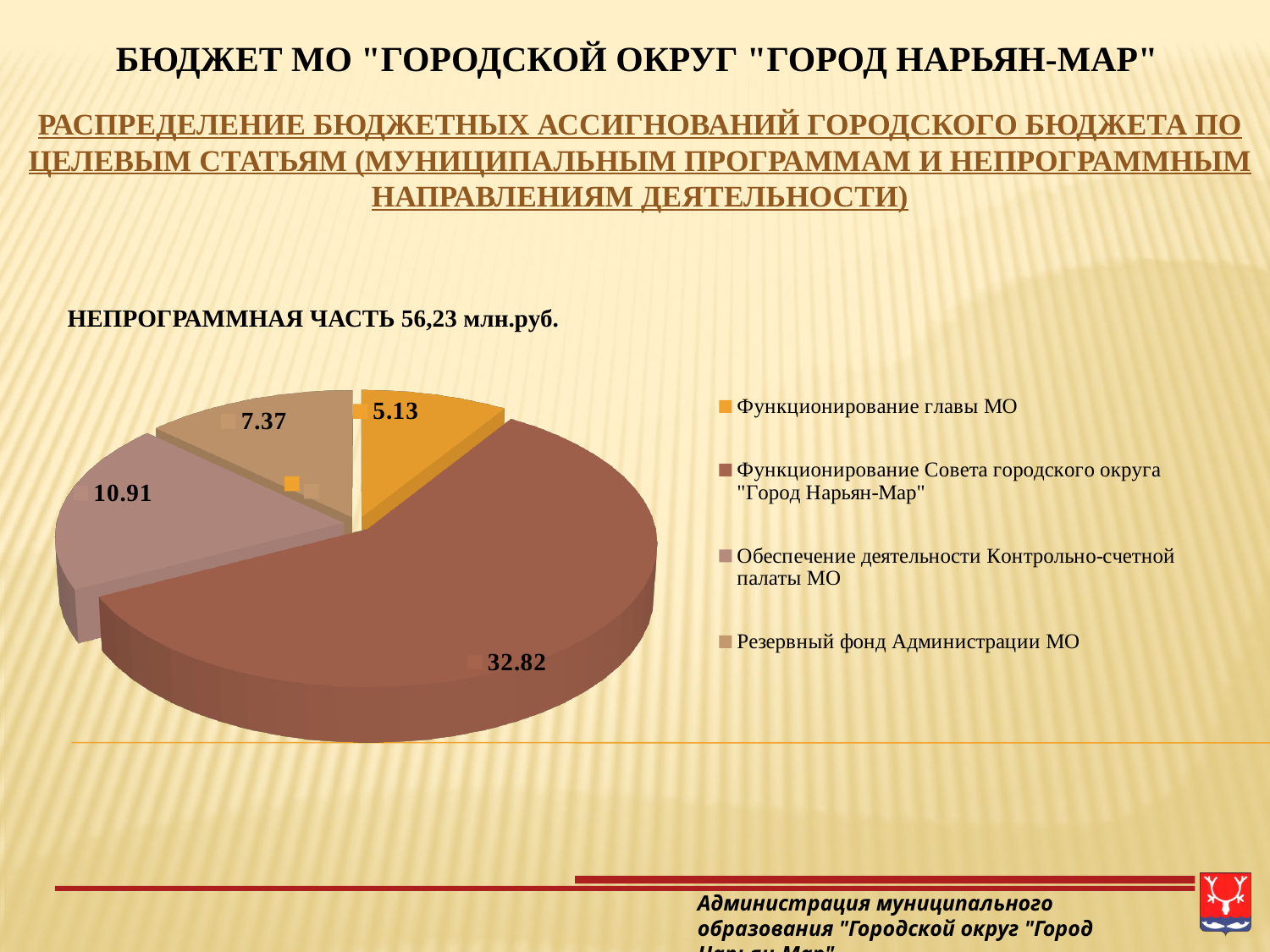
What is the value for "Обеспечение деятельности Контрольно-счетной палаты МО" in the pie chart? 10.91 What is the value for "Функционирование главы МО" in the pie chart? 5.13 Which category has the smallest slice in the pie chart? Функционирование главы МО What is the value for "Функционирование Совета городского округа "Город Нарьян-Мар"" in the pie chart? 32.82 How many entries does the legend of the pie chart list? 4 What type of chart is shown on the slide? Pie chart What is the difference between the values for "Функционирование Совета городского округа "Город Нарьян-Мар"" and "Функционирование главы МО"? 27.69 Which category has the largest slice in the pie chart? Функционирование Совета городского округа "Город Нарьян-Мар" What is the value for "Резервный фонд Администрации МО" in the pie chart? 7.37 Which is larger: the value for "Обеспечение деятельности Контрольно-счетной палаты МО" or for "Резервный фонд Администрации МО"? Обеспечение деятельности Контрольно-счетной палаты МО How many slices does the pie chart have? 4 What total amount for the non-programme part (НЕПРОГРАММНАЯ ЧАСТЬ) is stated above the pie chart? 56,23 млн.руб.